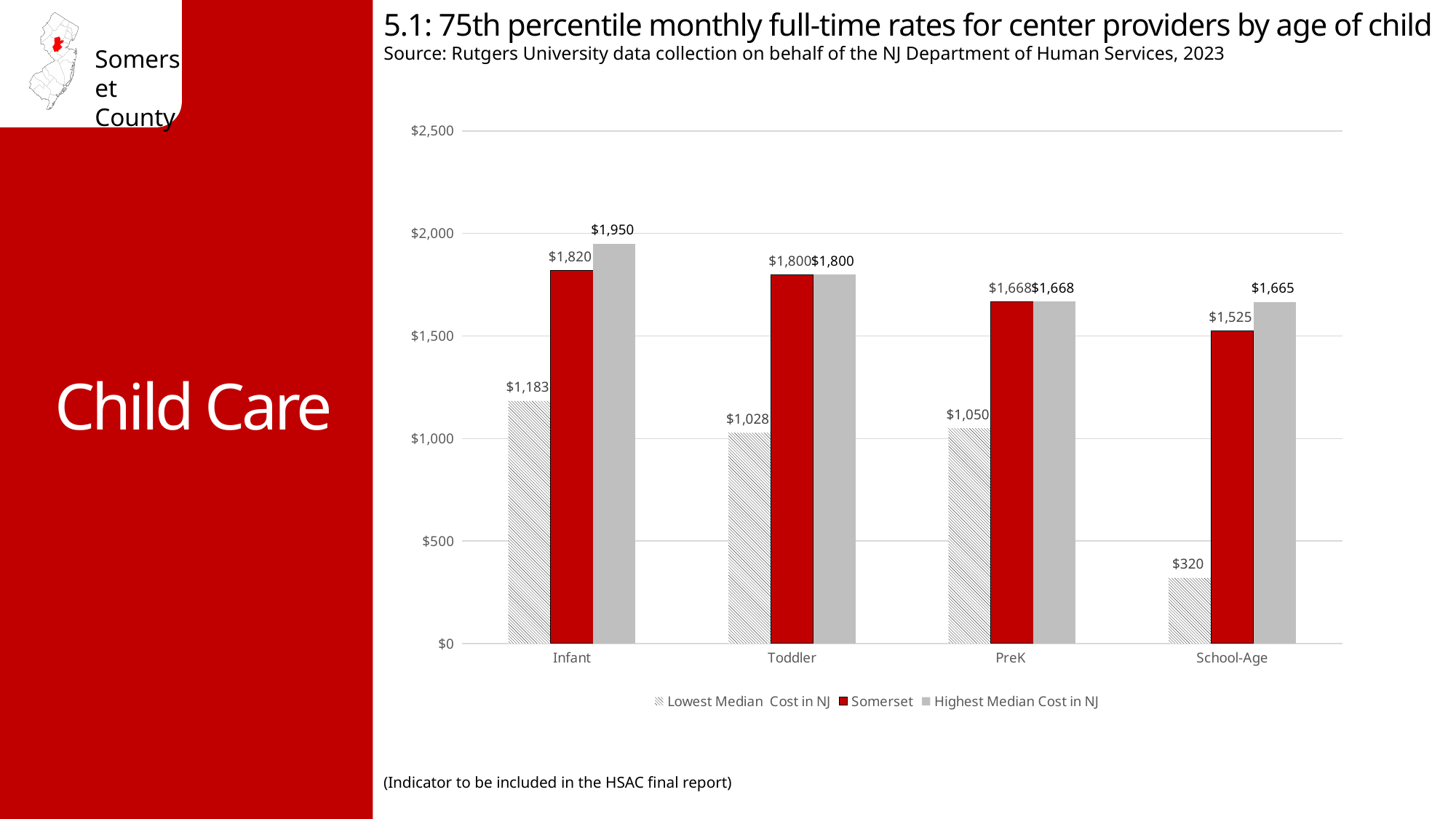
How many age groups are shown on the x axis? 4 How many series does the legend list? 3 What is the Somerset value for PreK? $1,668 Which age group has the lowest Lowest Median Cost in NJ value? School-Age Which is larger for Toddler: the Lowest Median Cost in NJ or the Somerset value? Somerset What kind of chart is shown on the slide? Bar chart Which age group has the highest Somerset value? Infant What is the Lowest Median Cost in NJ value for School-Age? $320 What is the Somerset value for Infant? $1,820 What is the Highest Median Cost in NJ value for Infant? $1,950 What is the difference between the Highest Median Cost in NJ and the Somerset value for School-Age? $140 Do the Somerset values rise or fall from Infant to School-Age? Fall